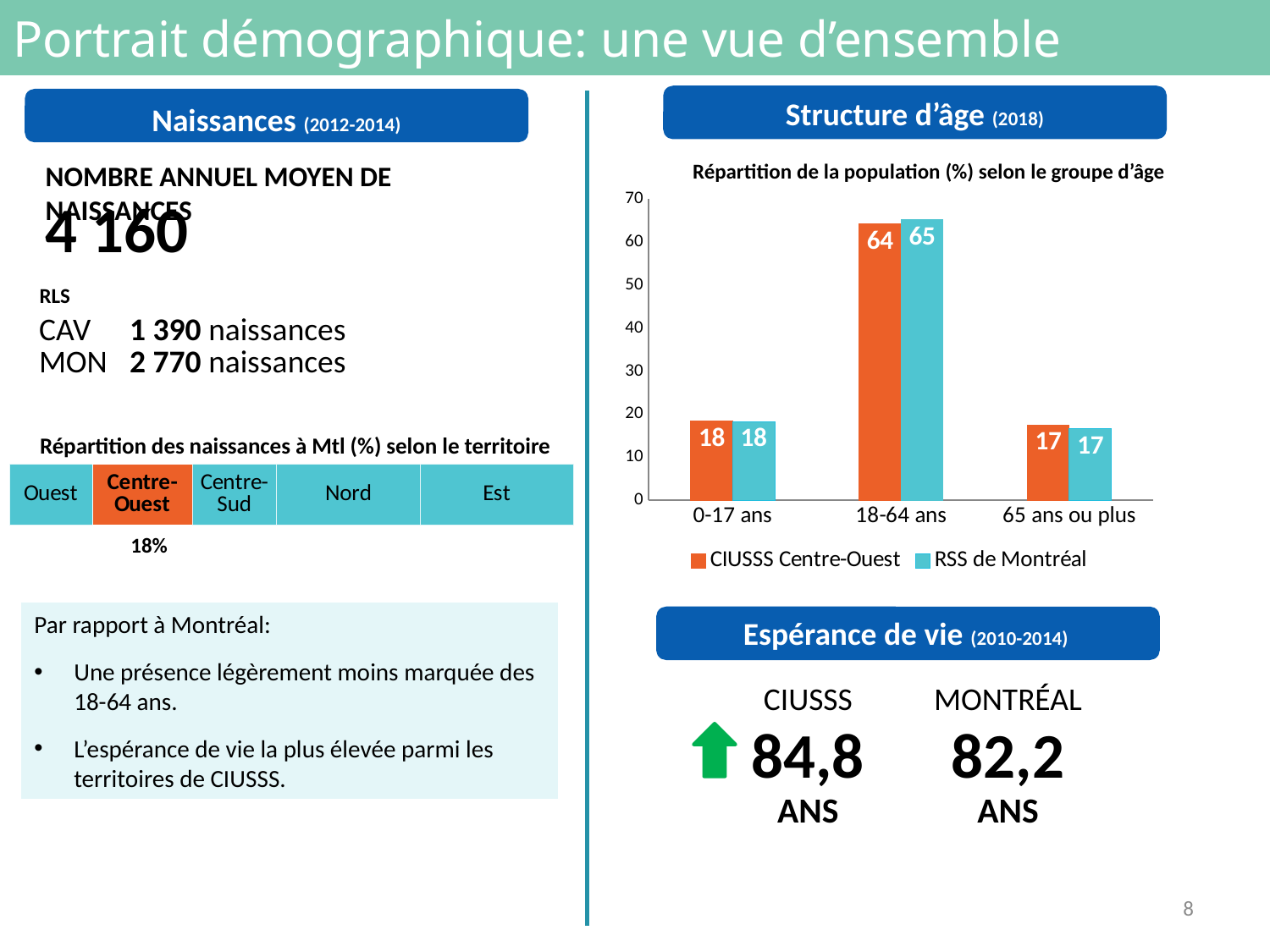
In the chart 'Répartition de la population (%) selon le groupe d'âge', what is the value for RSS de Montréal in the 18-64 ans group? 65 In the chart 'Répartition de la population (%) selon le groupe d'âge', what is the value for CIUSSS Centre-Ouest in the 0-17 ans group? 18 In the chart 'Répartition de la population (%) selon le groupe d'âge', what is the difference between the RSS de Montréal and CIUSSS Centre-Ouest values for the 18-64 ans group? 1 In the chart 'Répartition de la population (%) selon le groupe d'âge', what is the value for CIUSSS Centre-Ouest in the 18-64 ans group? 64 In the chart 'Répartition de la population (%) selon le groupe d'âge', how many age groups are shown on the x axis? 3 In the chart 'Répartition de la population (%) selon le groupe d'âge', what is the value for RSS de Montréal in the 65 ans ou plus group? 17 In the chart 'Répartition de la population (%) selon le groupe d'âge', which is larger for the 18-64 ans group: CIUSSS Centre-Ouest or RSS de Montréal? RSS de Montréal In the chart 'Répartition de la population (%) selon le groupe d'âge', which age group has the lowest value for RSS de Montréal? 65 ans ou plus In the chart 'Répartition de la population (%) selon le groupe d'âge', how many series does the legend list? 2 What kind of chart is 'Répartition de la population (%) selon le groupe d'âge'? Bar chart In the chart 'Répartition de la population (%) selon le groupe d'âge', which colour represents CIUSSS Centre-Ouest? Orange In the chart 'Répartition de la population (%) selon le groupe d'âge', which age group has the highest value for CIUSSS Centre-Ouest? 18-64 ans